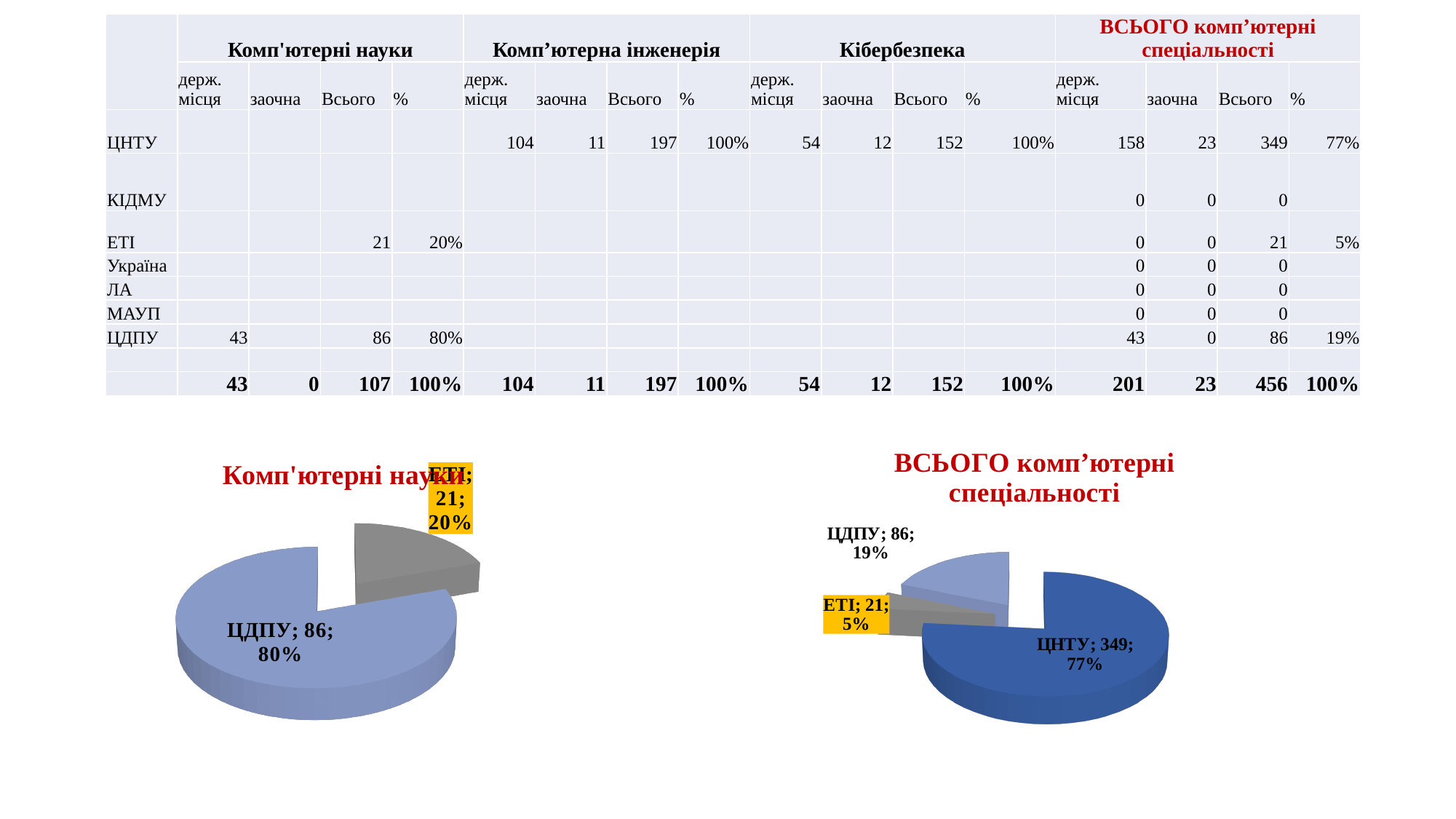
In the "ВСЬОГО комп'ютерні спеціальності" pie chart, which slice is the smallest? ЕТІ In the "ВСЬОГО комп'ютерні спеціальності" pie chart, what is the value for ЦНТУ? 349 In the "ВСЬОГО комп'ютерні спеціальності" pie chart, which is larger, the value for ЦДПУ or the value for ЕТІ? ЦДПУ How many slices does the "Комп'ютерні науки" pie chart have? 2 In the "Комп'ютерні науки" pie chart, what is the difference between the values for ЦДПУ and ЕТІ? 65 In the "ВСЬОГО комп'ютерні спеціальності" pie chart, what share of the pie does ЦДПУ have? 19% In the "Комп'ютерні науки" pie chart, what is the value for ЦДПУ? 86 In the "Комп'ютерні науки" pie chart, what share of the pie does ЕТІ have? 20% How many slices does the "ВСЬОГО комп'ютерні спеціальності" pie chart have? 3 In the "ВСЬОГО комп'ютерні спеціальності" pie chart, what is the difference between the values for ЦНТУ and ЦДПУ? 263 What kind of chart is the "Комп'ютерні науки" chart on the left? pie chart In the "Комп'ютерні науки" pie chart, which slice is the largest? ЦДПУ